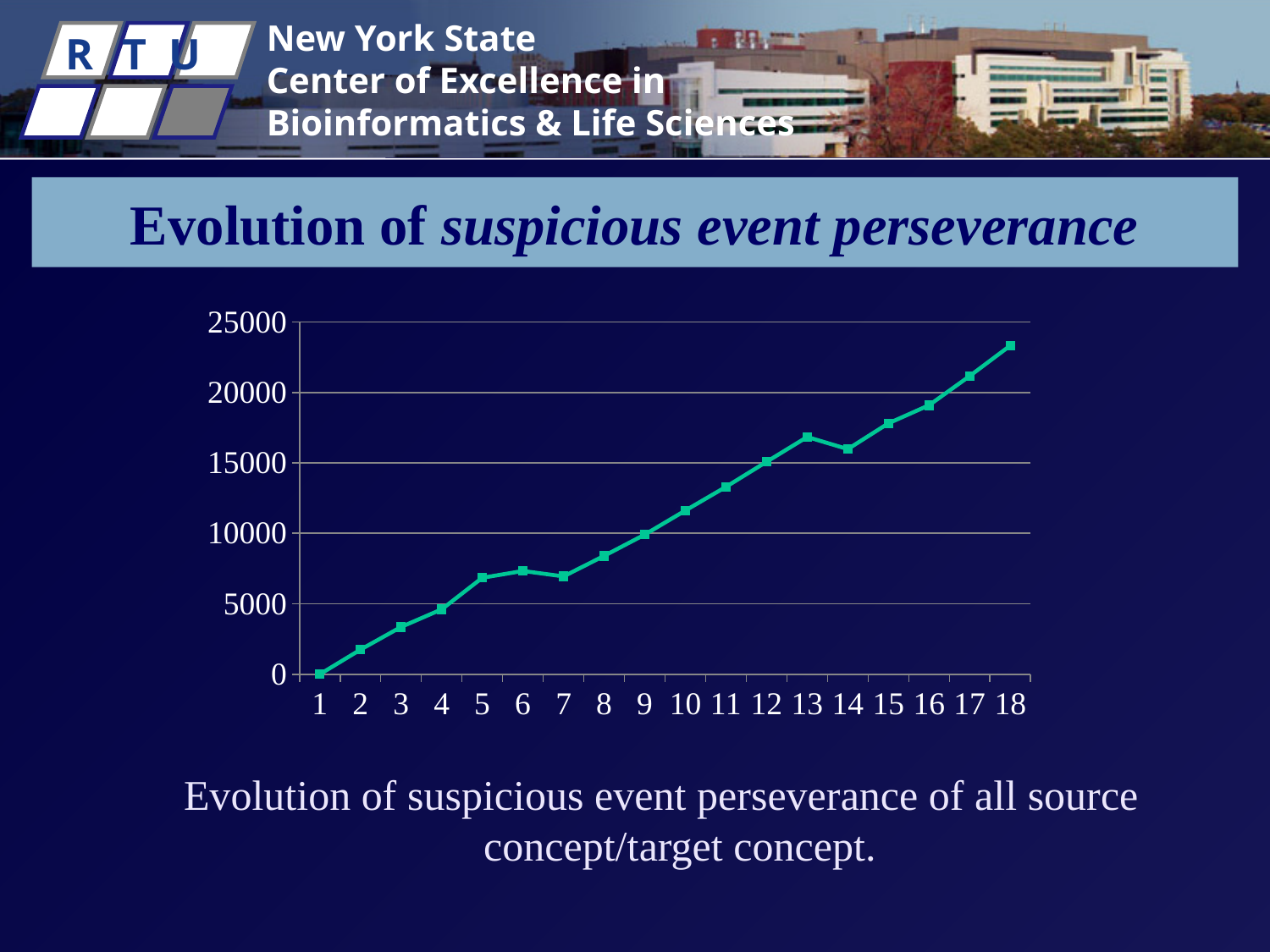
Is the value at point 18 greater or less than 20000? greater At which x-axis point is the value highest? 18 What is the title shown above the chart? Evolution of suspicious event perseverance How many points are plotted along the x axis of the chart? 18 What kind of chart is shown on the slide? line chart Is the value at point 3 greater or less than 5000? less At which x-axis point is the value lowest? 1 Do the values generally rise or fall from point 1 to point 18? rise Is the value at point 16 greater or less than 20000? less Which has the larger value, point 13 or point 14? point 13